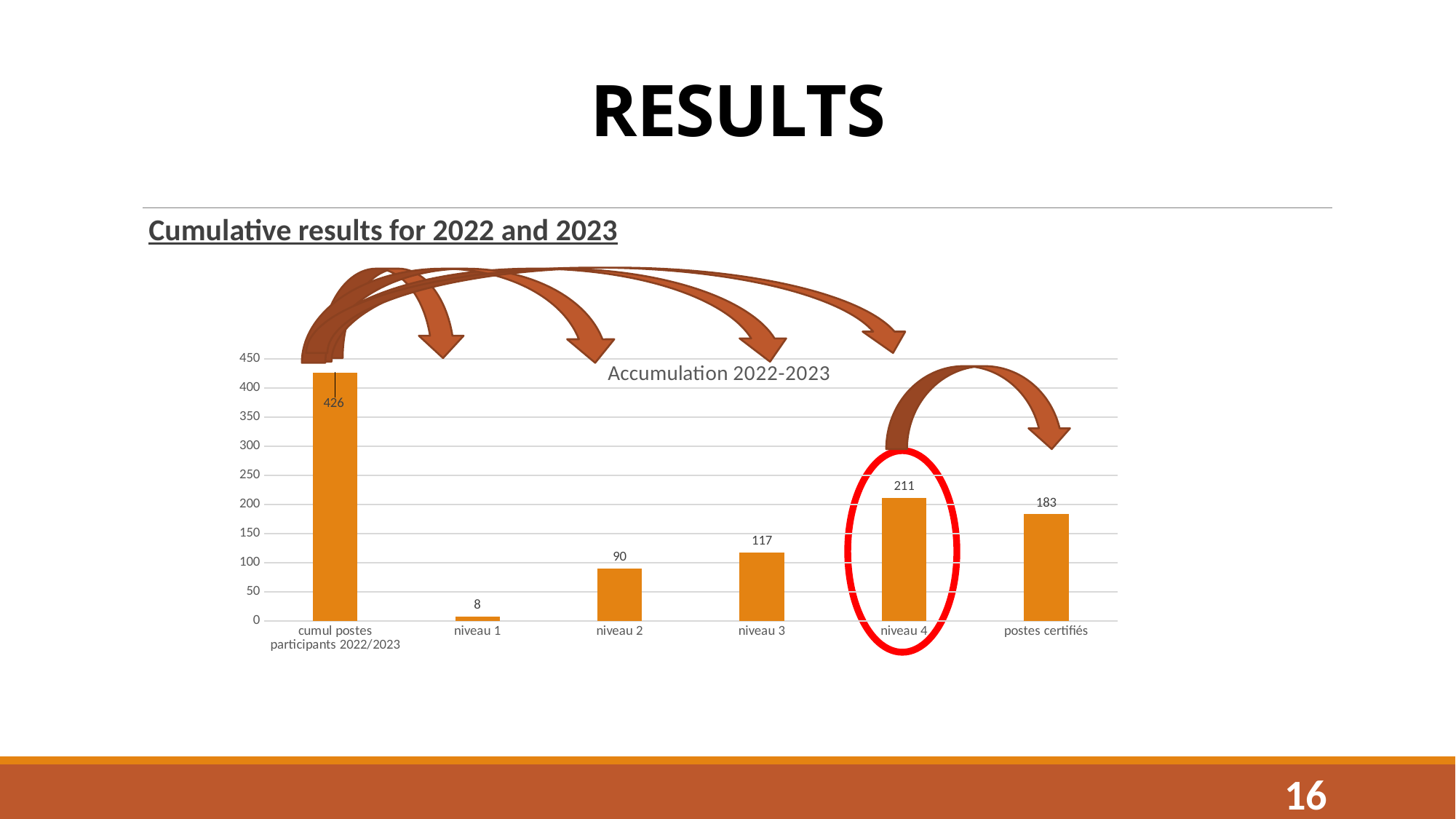
Which category has the highest value? cumul postes participants 2022/2023 What is the value for cumul postes participants 2022/2023? 426 What is the difference between the values for niveau 4 and postes certifiés? 28 Which is larger, the value for niveau 2 or the value for niveau 3? niveau 3 How many categories are shown on the x axis? 6 What kind of chart is shown on the slide? bar chart Which category has the lowest value? niveau 1 What is the title of the chart? Accumulation 2022-2023 What is the value for niveau 1? 8 What is the value for postes certifiés? 183 What is the difference between the values for niveau 3 and niveau 2? 27 What is the value for niveau 4? 211